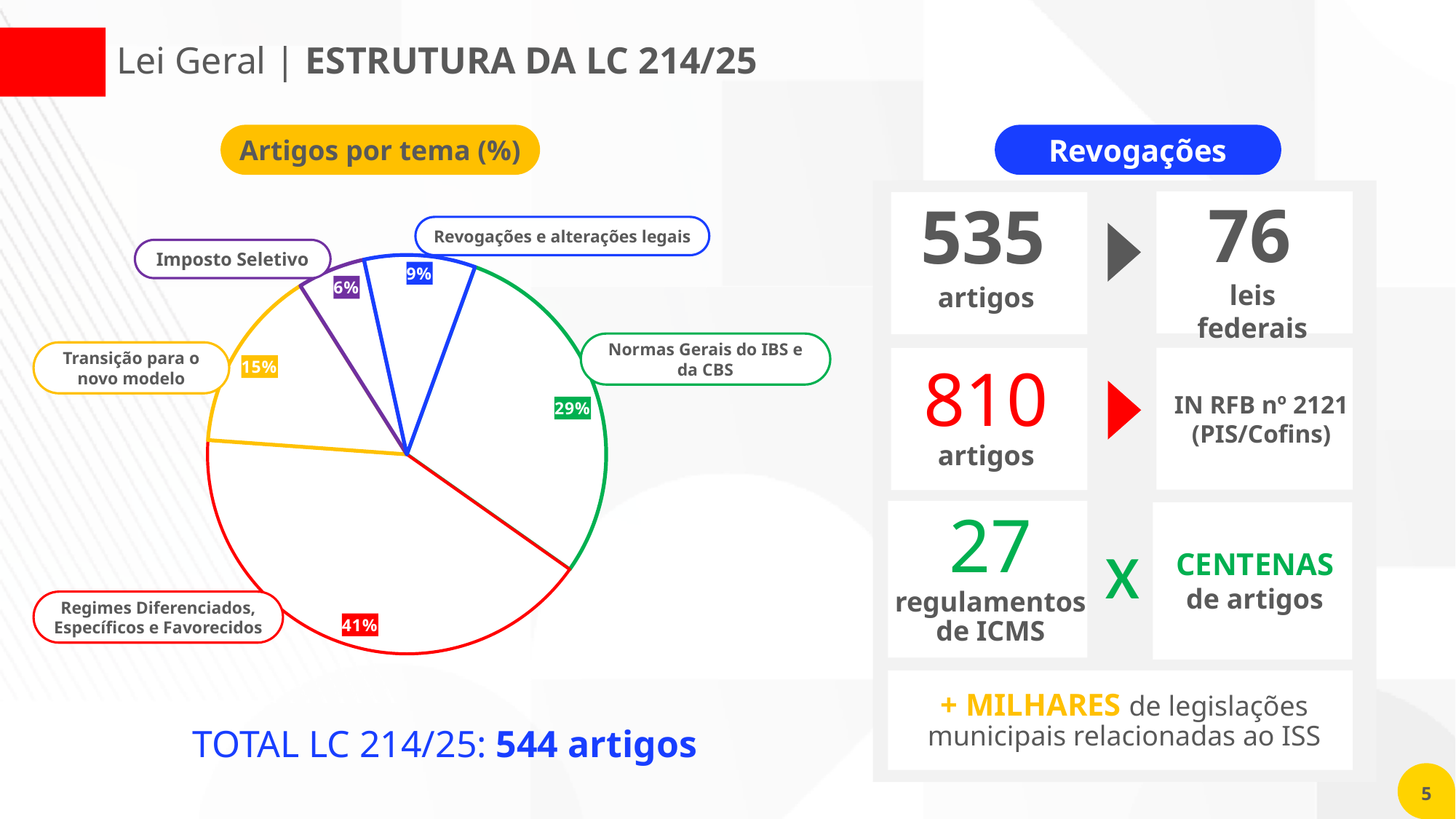
What percentage is shown for "Revogações e alterações legais"? 9% What percentage is shown for "Imposto Seletivo"? 6% What percentage is shown for "Transição para o novo modelo"? 15% Which is larger: the share for "Transição para o novo modelo" or the share for "Revogações e alterações legais"? Transição para o novo modelo What percentage is shown for "Normas Gerais do IBS e da CBS"? 29% What is the difference in percentage points between "Regimes Diferenciados, Específicos e Favorecidos" and "Normas Gerais do IBS e da CBS"? 12 How many slices does the pie chart have? 5 What kind of chart is shown under the heading "Artigos por tema (%)"? pie chart What percentage of articles does the "Regimes Diferenciados, Específicos e Favorecidos" slice represent? 41% Which theme has the smallest share of the pie chart? Imposto Seletivo Which theme has the largest share of the pie chart? Regimes Diferenciados, Específicos e Favorecidos What colour is the slice for "Normas Gerais do IBS e da CBS"? green